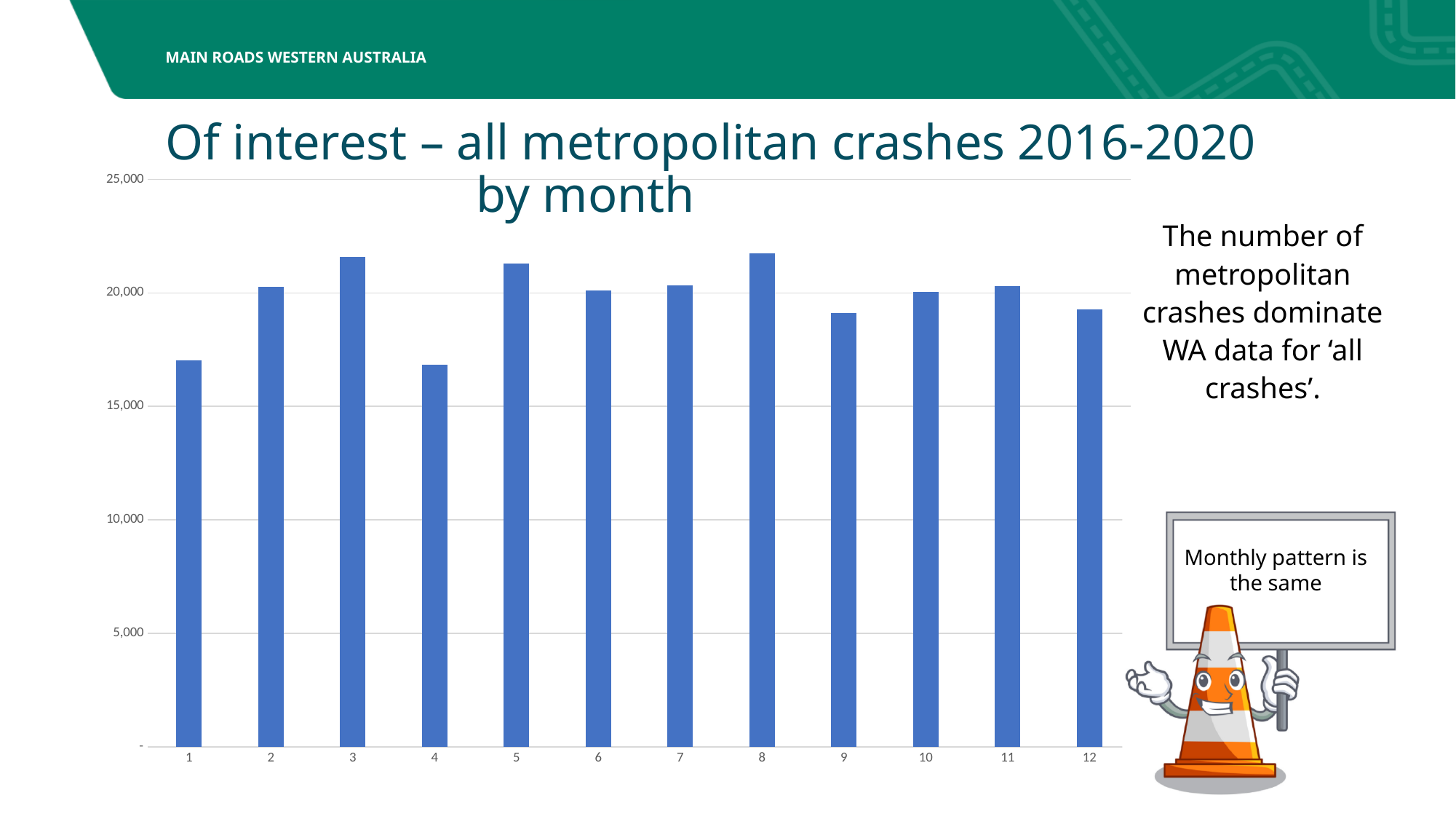
Is the value for month 9 greater or less than 20,000? less Which month has the larger value, month 4 or month 8? month 8 Is the value for month 8 greater or less than 20,000? greater Which month has the larger value, month 1 or month 3? month 3 Which month has the larger value, month 9 or month 5? month 5 What is the title of the chart on the slide? Of interest – all metropolitan crashes 2016-2020 by month Is the value for month 1 greater or less than 20,000? less How many months (categories) are plotted on the x axis of the chart? 12 What kind of chart is shown on the slide? bar chart